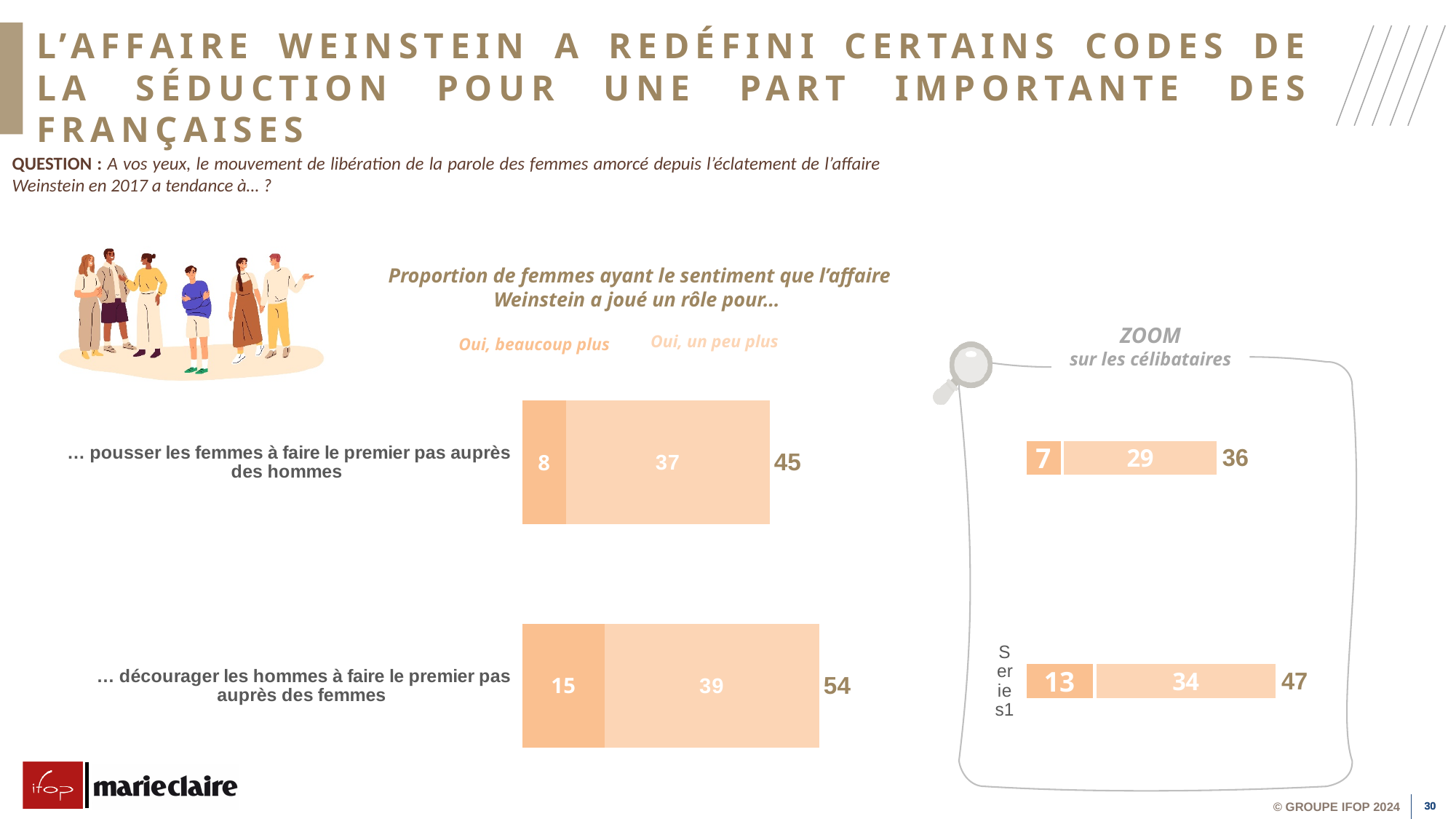
In the main chart 'Proportion de femmes ayant le sentiment que l'affaire Weinstein a joué un rôle pour…', what is the 'Oui, beaucoup plus' value for '… pousser les femmes à faire le premier pas auprès des hommes'? 8 In the main chart, which category has the higher total? … décourager les hommes à faire le premier pas auprès des femmes In the main chart, how many series does the legend list? 2 In the 'ZOOM sur les célibataires' chart, what is the difference between the totals of the bottom bar and the top bar? 11 In the 'ZOOM sur les célibataires' chart, what is the first (darker) segment value of the bottom bar? 13 In the 'ZOOM sur les célibataires' chart, what is the total shown for the top bar? 36 In the main chart, what is the total shown for '… pousser les femmes à faire le premier pas auprès des hommes'? 45 In the main chart, what is the 'Oui, un peu plus' value for '… décourager les hommes à faire le premier pas auprès des femmes'? 39 In the main chart, how many categories are plotted? 2 In the main chart, what is the total shown for '… décourager les hommes à faire le premier pas auprès des femmes'? 54 What kind of chart is the main chart? Stacked bar chart In the main chart, what is the difference between the 'Oui, beaucoup plus' values of the two categories? 7